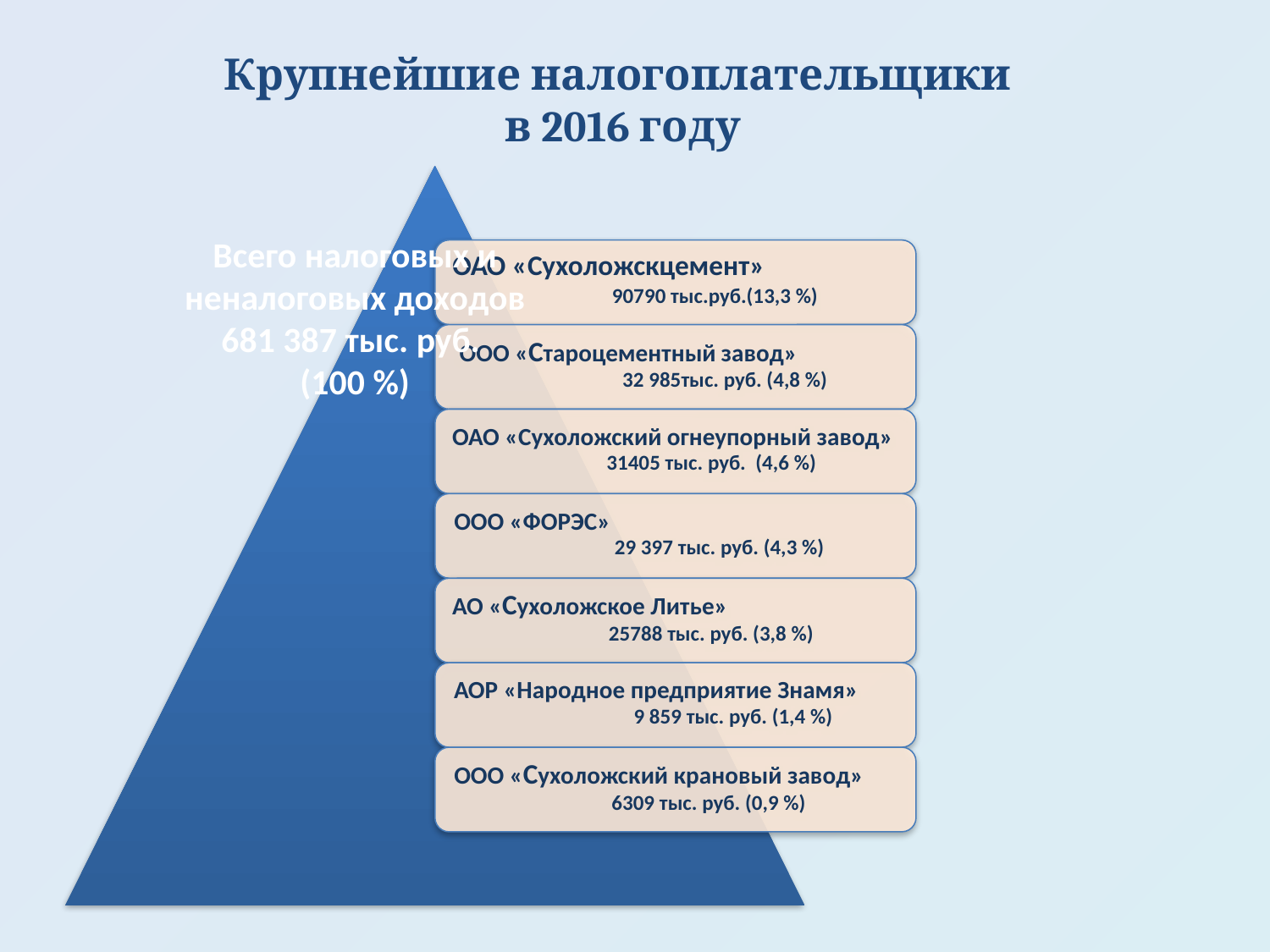
Which has the larger amount: ООО «Староцементный завод» or АО «Сухоложское Литье»? ООО «Староцементный завод» What amount is shown for ООО «ФОРЭС»? 29 397 тыс. руб. What is the difference in share between ОАО «Сухоложскцемент» and ООО «Староцементный завод»? 8,5 % Which taxpayer has the largest amount? ОАО «Сухоложскцемент» How many taxpayers are listed in the pyramid diagram? 7 What share is shown for АОР «Народное предприятие Знамя»? 1,4 % What is the total of tax and non-tax revenues shown on the slide? 681 387 тыс. руб. What is the difference in amount between АОР «Народное предприятие Знамя» and ООО «Сухоложский крановый завод»? 3 550 тыс. руб. What amount is shown for ОАО «Сухоложскцемент»? 90790 тыс.руб. Which taxpayer has the smallest amount? ООО «Сухоложский крановый завод» What is the title of the diagram on the slide? Крупнейшие налогоплательщики в 2016 году What share is shown for ОАО «Сухоложскцемент»? 13,3 %